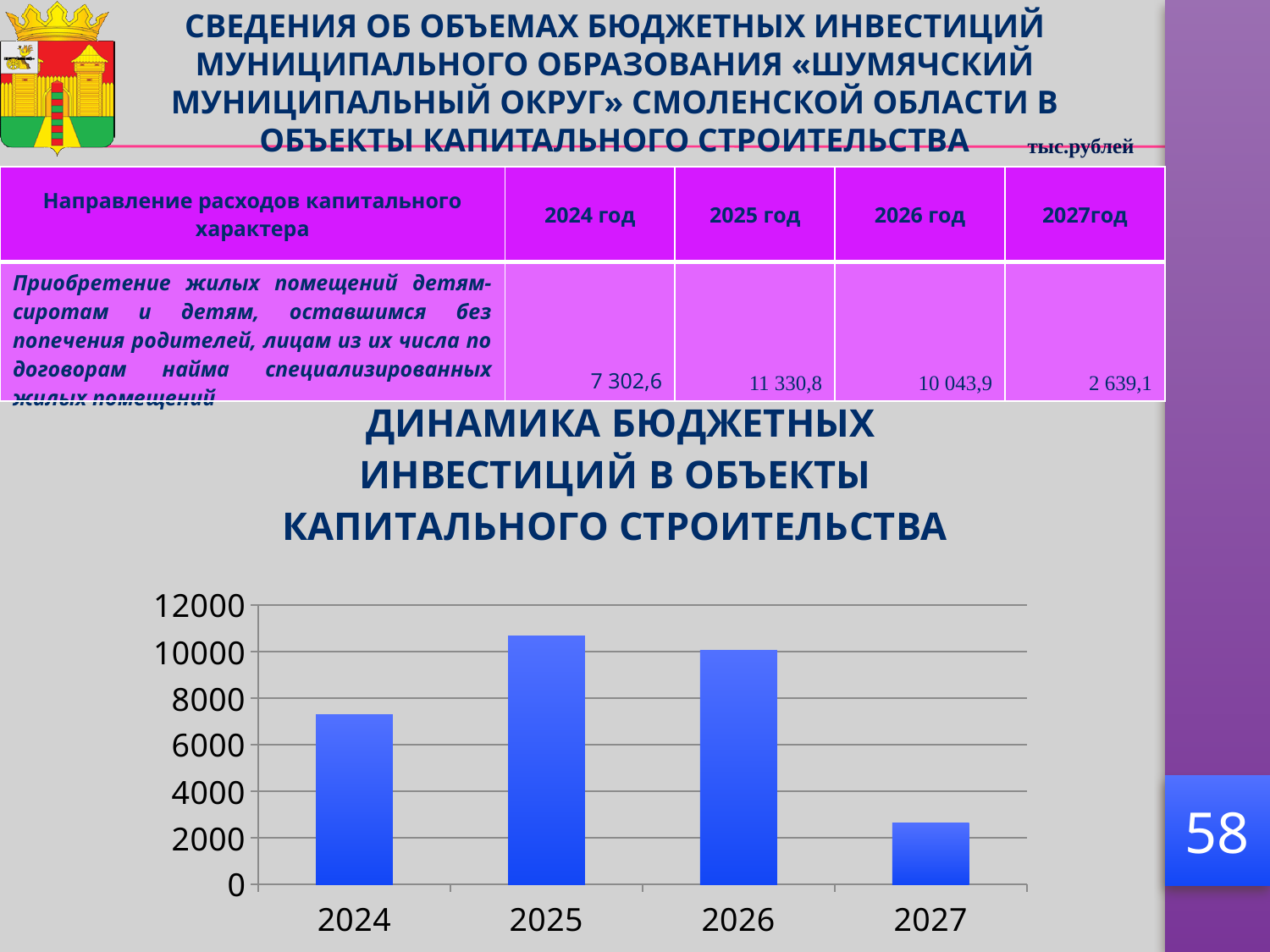
Is the value for 2027 greater or less than 4000? less Is the value for 2024 greater or less than 8000? less Is the value for 2025 greater or less than 10000? greater Which is larger, the value for 2024 or the value for 2027? 2024 What kind of chart is shown on the slide? bar chart Which year has the lowest bar in the chart? 2027 Which year has the highest bar in the chart? 2025 What is the highest tick value shown on the chart's vertical axis? 12000 How many years are shown on the x axis of the chart? 4 Which is larger, the value for 2025 or the value for 2024? 2025 Do the values rise or fall from 2025 to 2027? fall